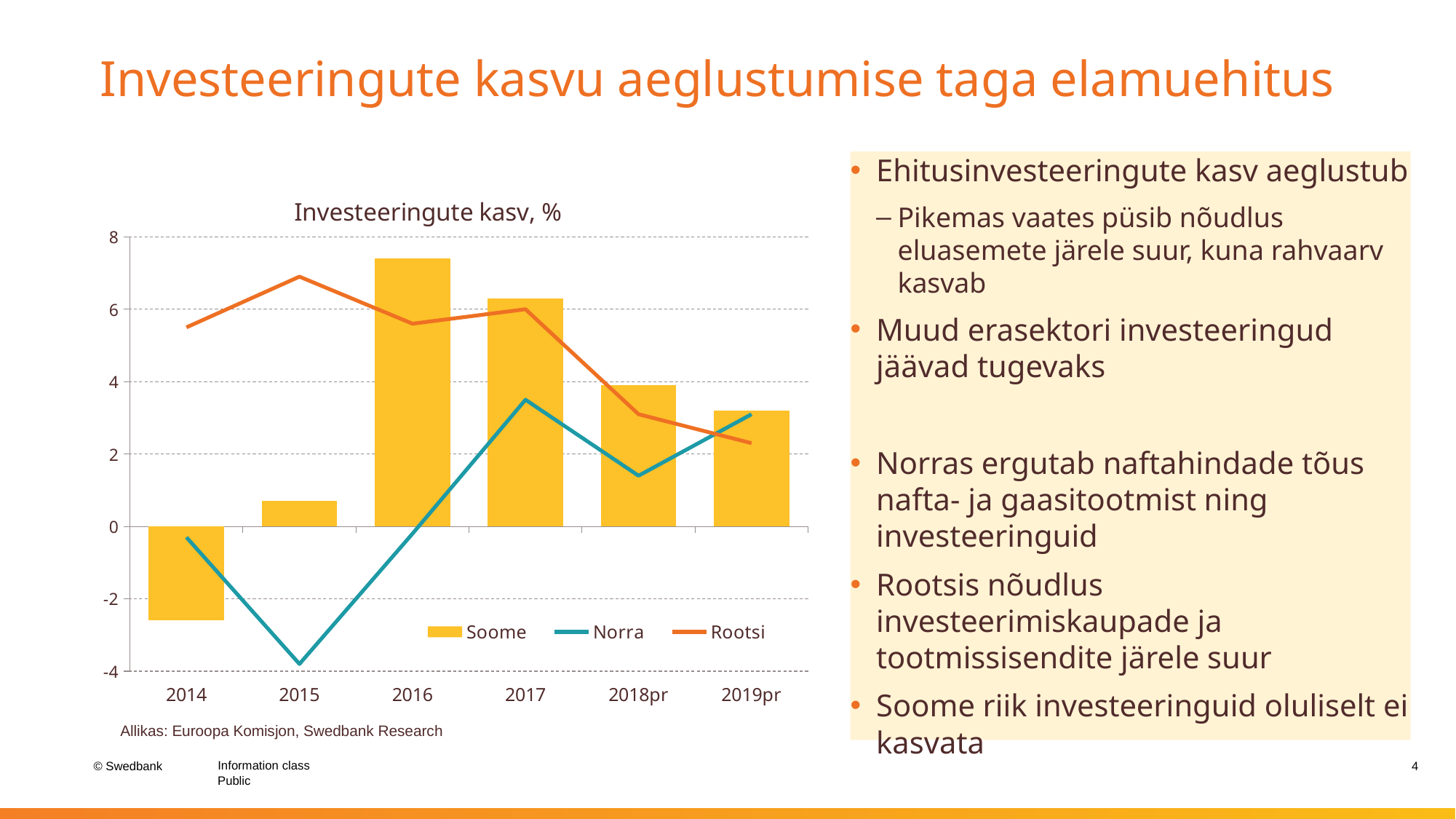
How many series does the chart legend list? 3 What is the title of the chart? Investeeringute kasv, % How many years (categories) are shown on the x axis of the chart? 6 In which year does the Rootsi line reach its highest point? 2015 Which is larger in 2016, the value for Soome or the value for Rootsi? Soome Is the value for Norra in 2015 greater or less than -2? less Does the Rootsi line rise or fall from 2017 to 2019pr? It falls In which year does the Norra line reach its lowest point? 2015 Is the value for Soome in 2016 greater or less than 6? greater What kind of chart is shown on the slide? A combined bar and line chart In which year is the Soome bar lowest? 2014 In which year is the Soome bar highest? 2016